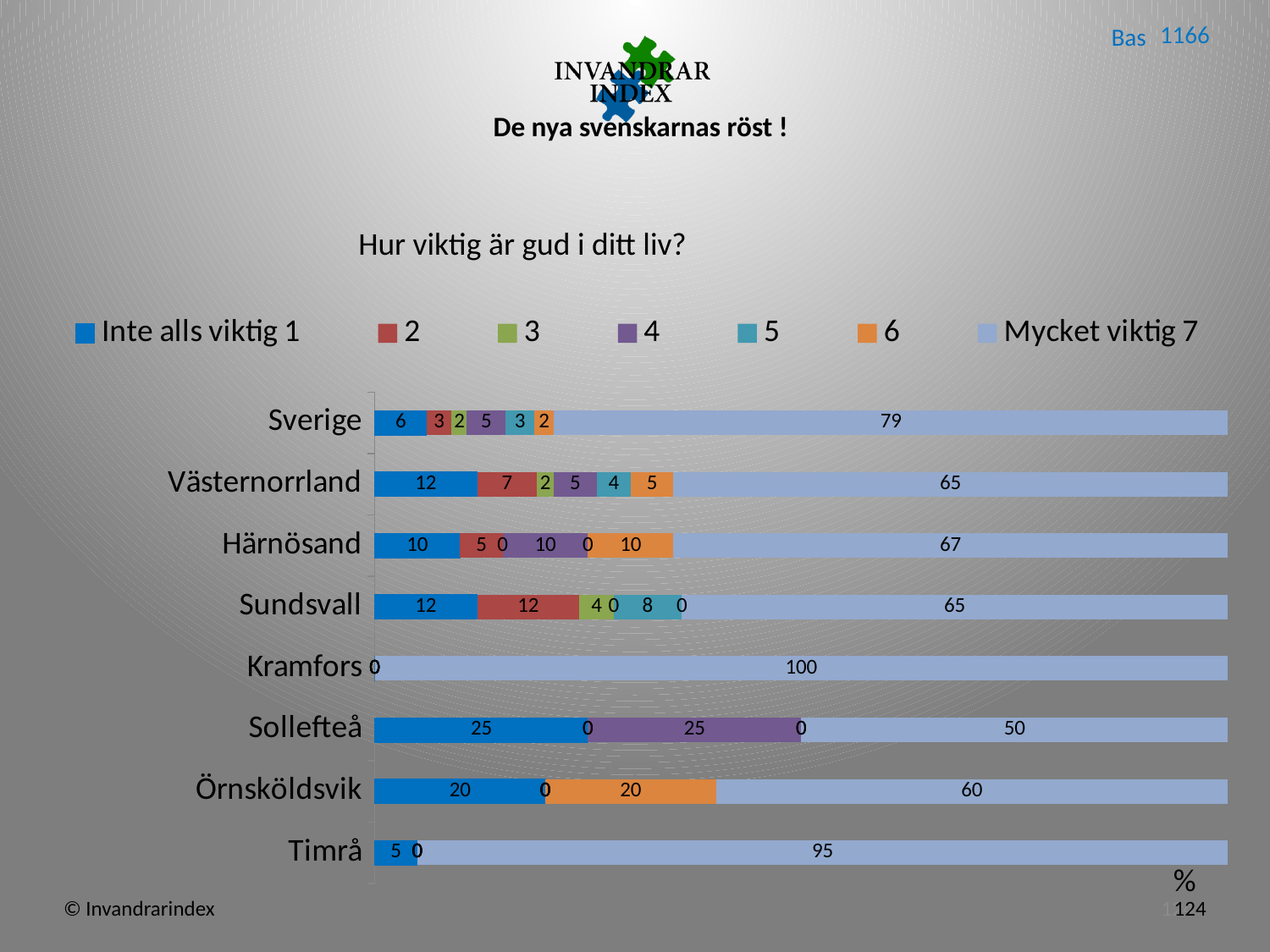
Which category has the lowest value for 'Mycket viktig 7'? Sollefteå What is the difference between the 'Mycket viktig 7' values for Sverige and Västernorrland? 14 Which is larger, the 'Mycket viktig 7' value for Härnösand or for Sundsvall? Härnösand Which category has the highest value for 'Mycket viktig 7'? Kramfors What is the value of 'Mycket viktig 7' for Timrå? 95 How many categories are shown on the chart? 8 What is the title of the chart? Hur viktig är gud i ditt liv? How many series does the legend list? 7 What is the value of 'Mycket viktig 7' for Kramfors? 100 What is the value of 'Mycket viktig 7' for Sverige? 79 What is the value of 'Inte alls viktig 1' for Västernorrland? 12 What kind of chart is shown on the slide? Stacked bar chart